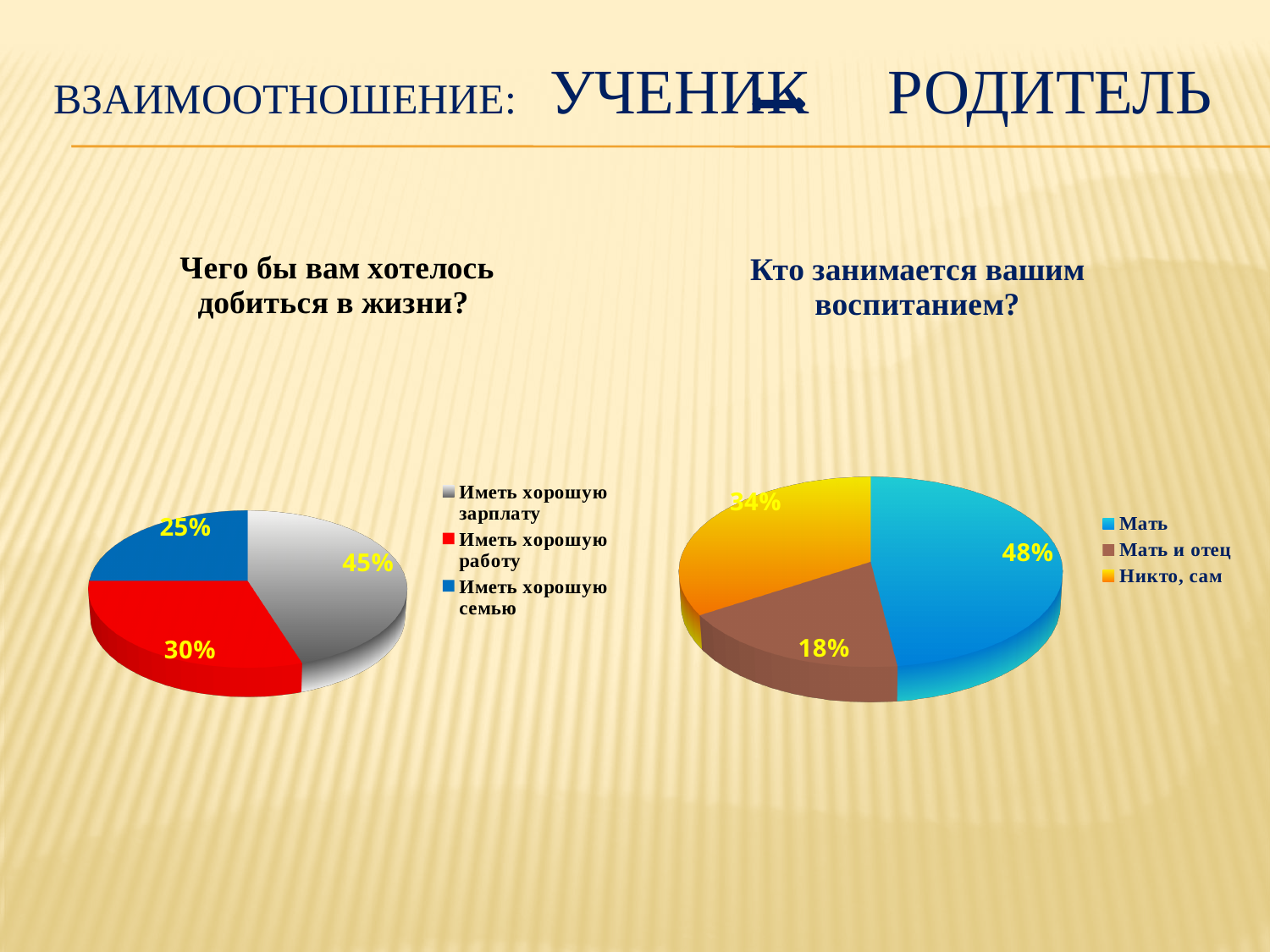
In the right chart "Кто занимается вашим воспитанием?", what percentage is shown for "Мать"? 48% How many categories does the legend of the right chart "Кто занимается вашим воспитанием?" list? 3 In the right chart "Кто занимается вашим воспитанием?", which is larger: "Мать" or "Никто, сам"? Мать In the right chart "Кто занимается вашим воспитанием?", which category has the smallest share? Мать и отец In the right chart "Кто занимается вашим воспитанием?", what percentage is shown for "Мать и отец"? 18% In the left chart "Чего бы вам хотелось добиться в жизни?", which category has the largest share? Иметь хорошую зарплату In the left chart "Чего бы вам хотелось добиться в жизни?", which category has the smallest share? Иметь хорошую семью What type of chart is the left chart "Чего бы вам хотелось добиться в жизни?"? Pie chart In the left chart "Чего бы вам хотелось добиться в жизни?", what is the difference in percentage points between "Иметь хорошую зарплату" and "Иметь хорошую работу"? 15 In the left chart "Чего бы вам хотелось добиться в жизни?", what percentage is shown for "Иметь хорошую зарплату"? 45% In the left chart "Чего бы вам хотелось добиться в жизни?", what percentage is shown for "Иметь хорошую семью"? 25% In the right chart "Кто занимается вашим воспитанием?", what is the difference in percentage points between "Мать" and "Мать и отец"? 30